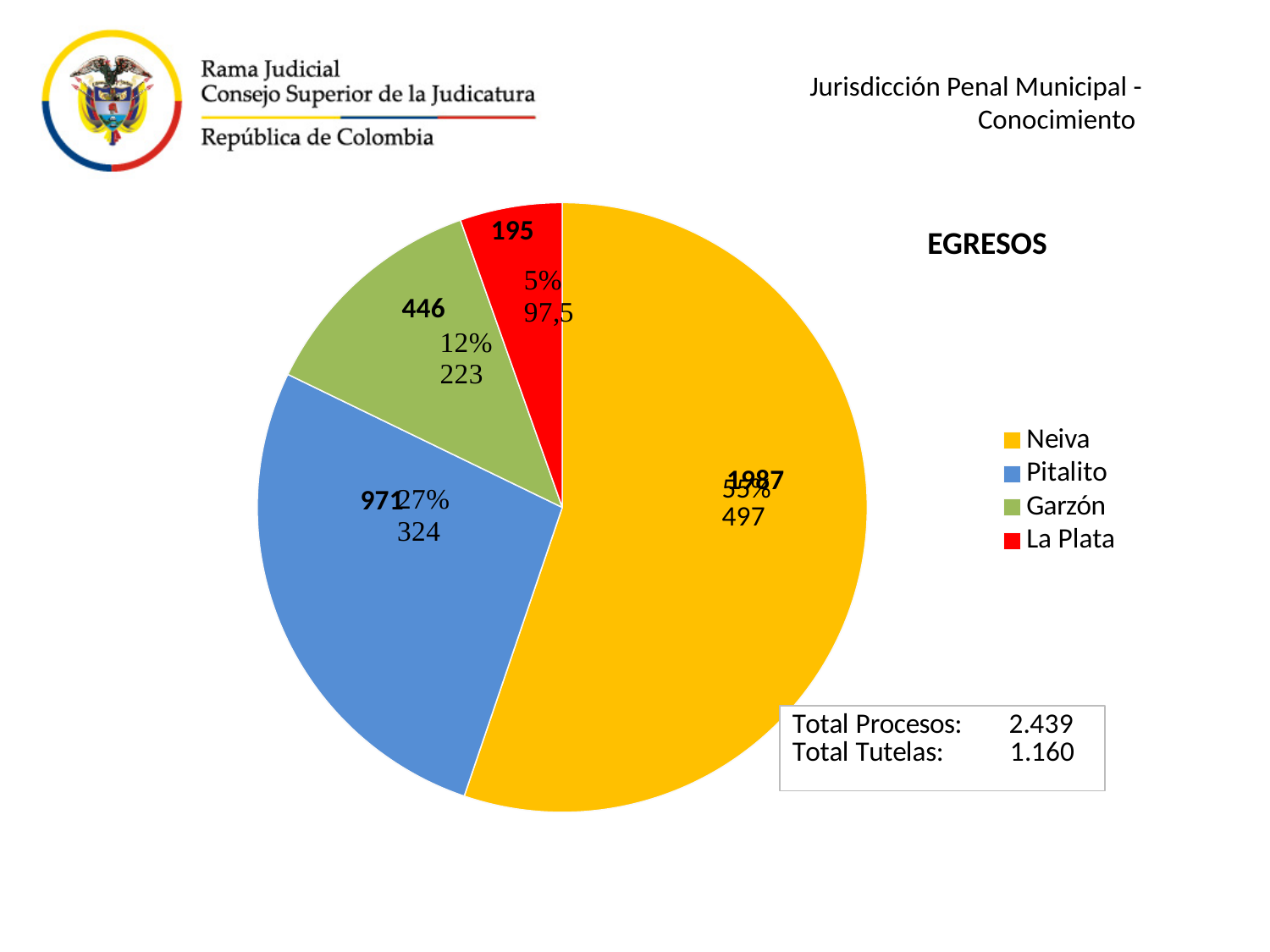
What is the value shown for Pitalito in the pie chart? 971 What is the title of the pie chart? EGRESOS What is the value shown for Neiva in the pie chart? 1987 What percentage share of the pie does La Plata have? 5% Which category has the largest slice of the pie? Neiva How many slices does the pie chart have? 4 What percentage share of the pie does Garzón have? 12% What is the value shown for Garzón in the pie chart? 446 What is the difference between the values for Garzón and La Plata? 251 What is the value shown for La Plata in the pie chart? 195 Which category has the smallest slice of the pie? La Plata What kind of chart is shown on the slide? pie chart